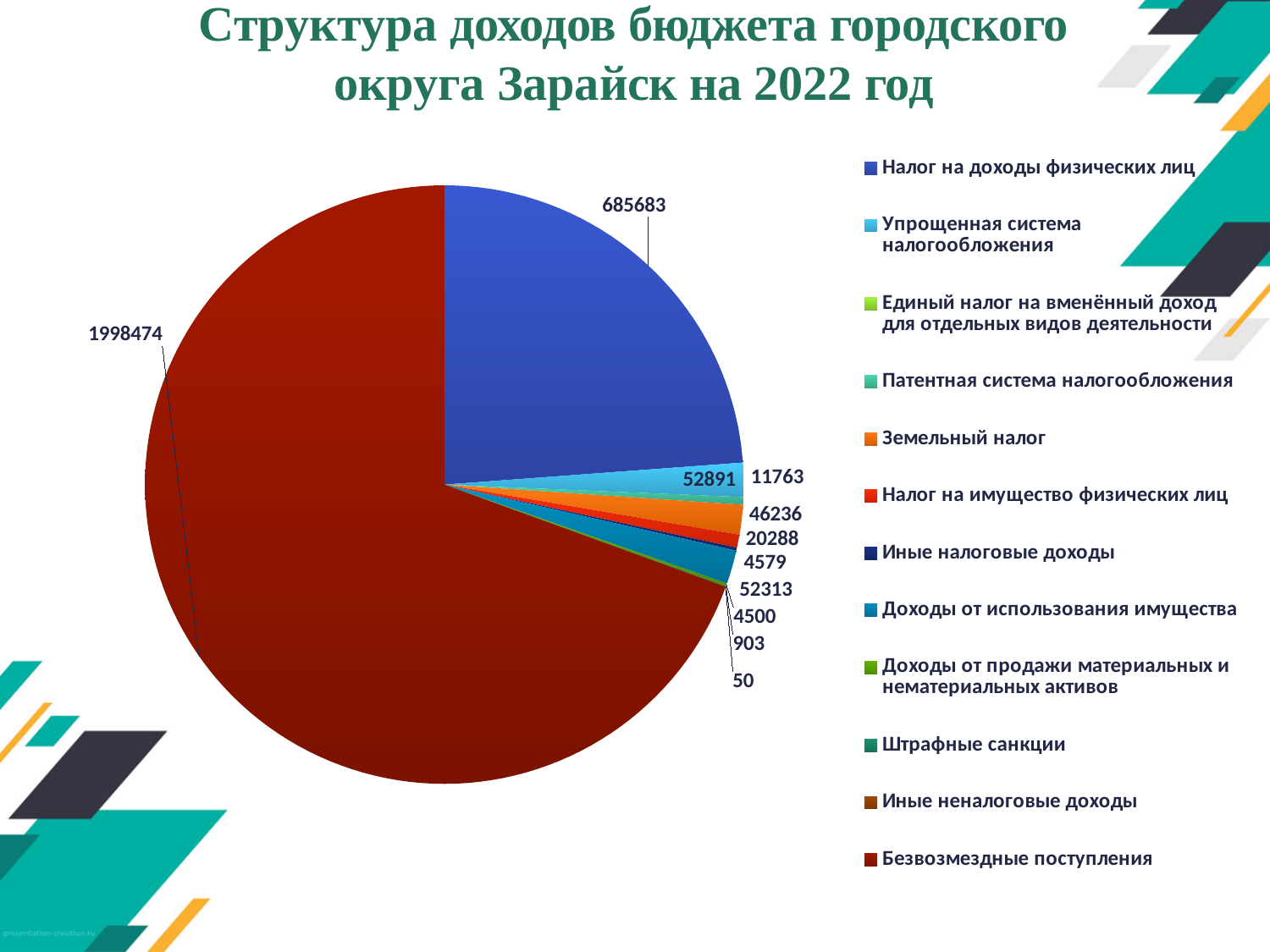
Which category has the largest slice of the pie? Безвозмездные поступления What is the value shown for Налог на доходы физических лиц? 685683 How many categories does the legend of the pie chart list? 12 What is the value shown for Упрощенная система налогообложения? 52891 What is the value shown for Земельный налог? 46236 Which is larger: the value for Налог на доходы физических лиц or the value for Упрощенная система налогообложения? Налог на доходы физических лиц What is the smallest value printed on the pie chart? 50 What is the value shown for Безвозмездные поступления? 1998474 What is the difference between the values for Безвозмездные поступления and Налог на доходы физических лиц? 1312791 What colour is the slice for Безвозмездные поступления? dark red What kind of chart is shown on the slide? pie chart What is the title of the slide containing the pie chart? Структура доходов бюджета городского округа Зарайск на 2022 год